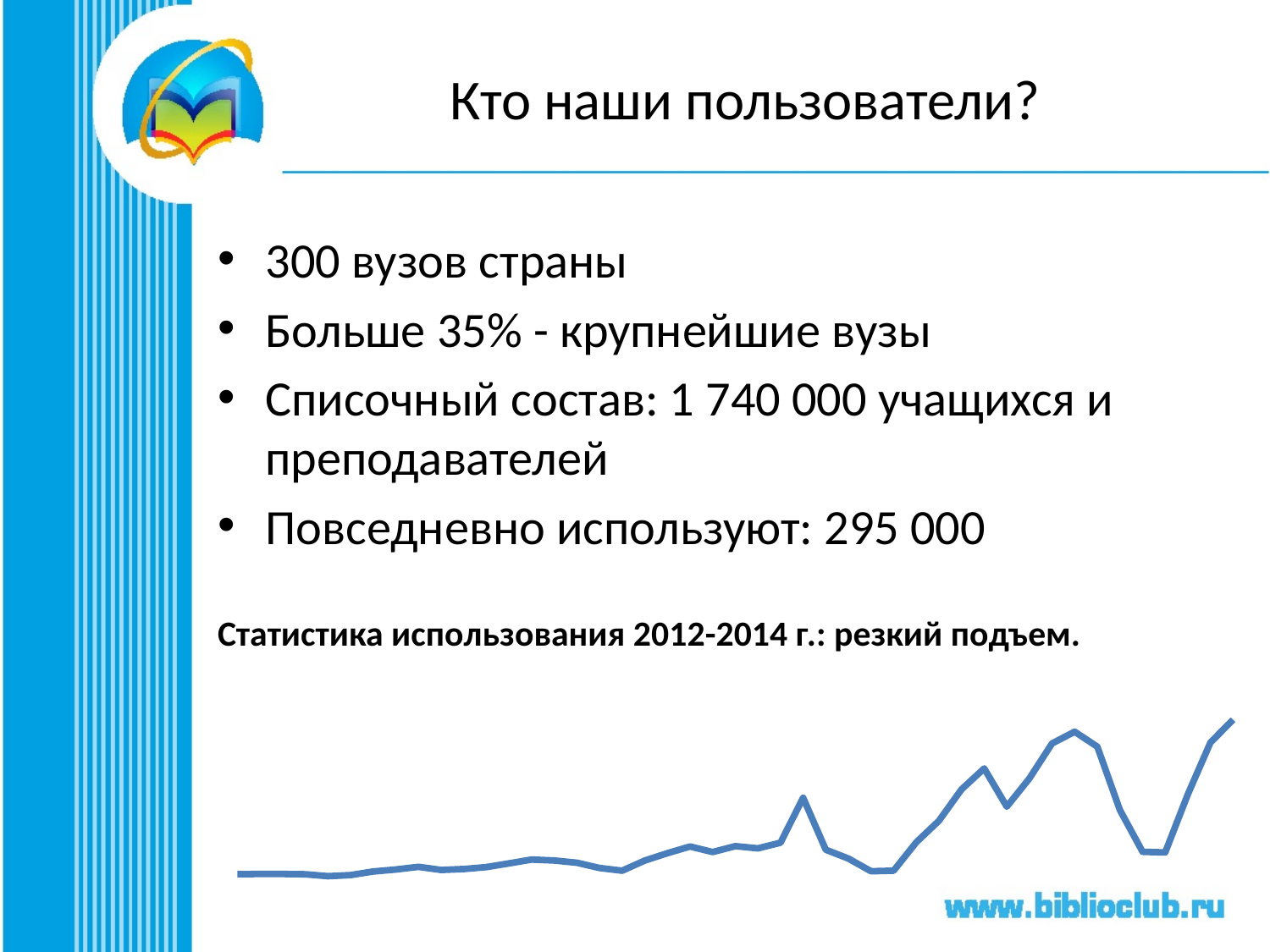
What colour is the line on the chart? blue How many lines are plotted on the chart? 1 What kind of chart is shown at the bottom of the slide? line chart What caption is printed above the line chart? Статистика использования 2012-2014 г.: резкий подъем. Do the values on the line chart generally rise or fall from left to right? rise Which years does the caption above the chart say the usage statistics cover? 2012-2014